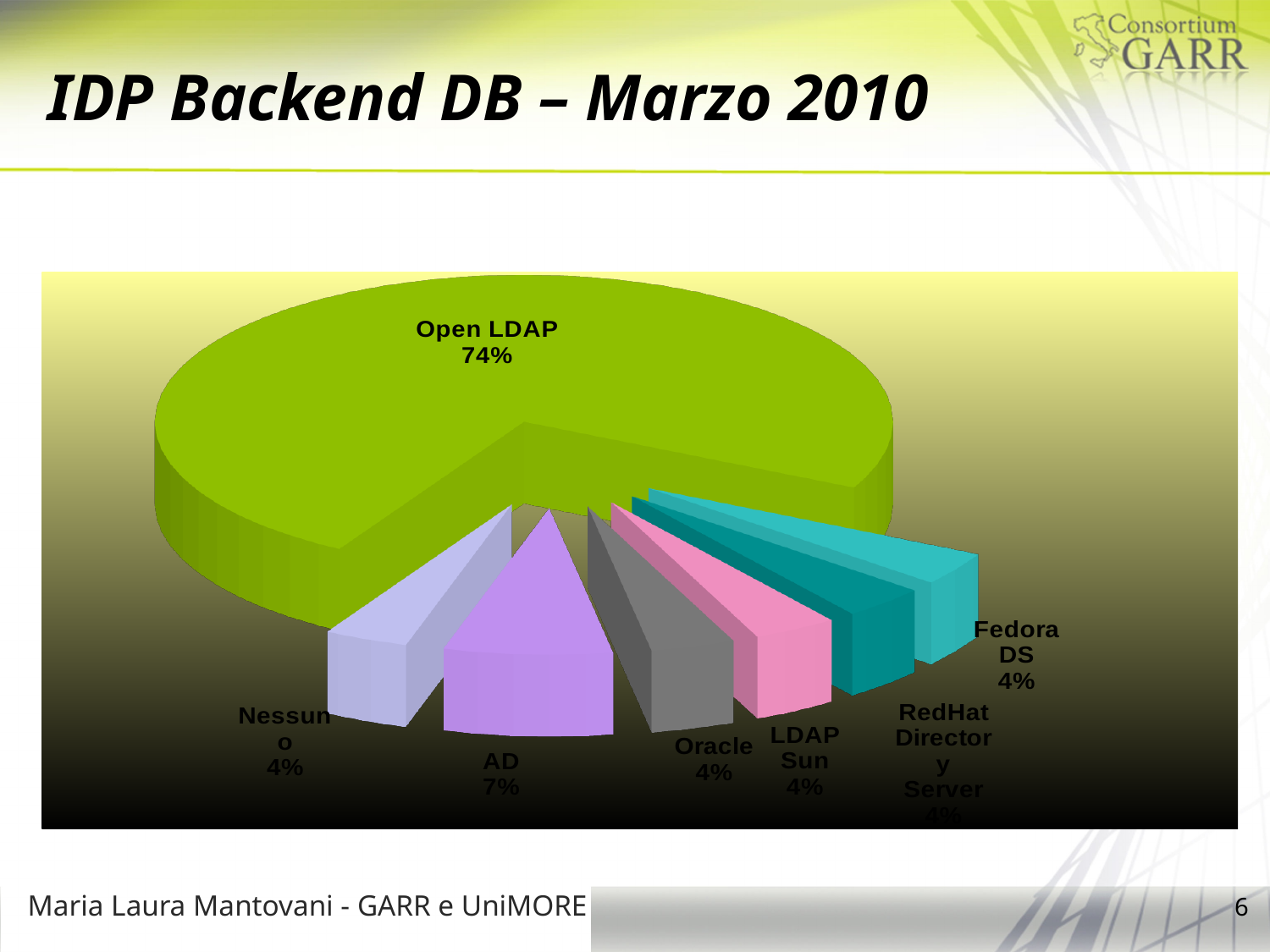
What kind of chart is shown on the slide? pie chart What is the value shown for AD? 7% How many slices does the pie chart have? 7 What share of the pie does Open LDAP hold? 74% Which is larger, the share for AD or the share for LDAP Sun? AD What is the difference in percentage points between Open LDAP and AD? 67 What is the difference in percentage points between AD and Oracle? 3 What is the value shown for Fedora DS? 4% What is the value shown for Oracle? 4% What is the title of the slide containing the chart? IDP Backend DB – Marzo 2010 What is the value shown for Nessuno? 4% Which category has the largest slice of the pie? Open LDAP